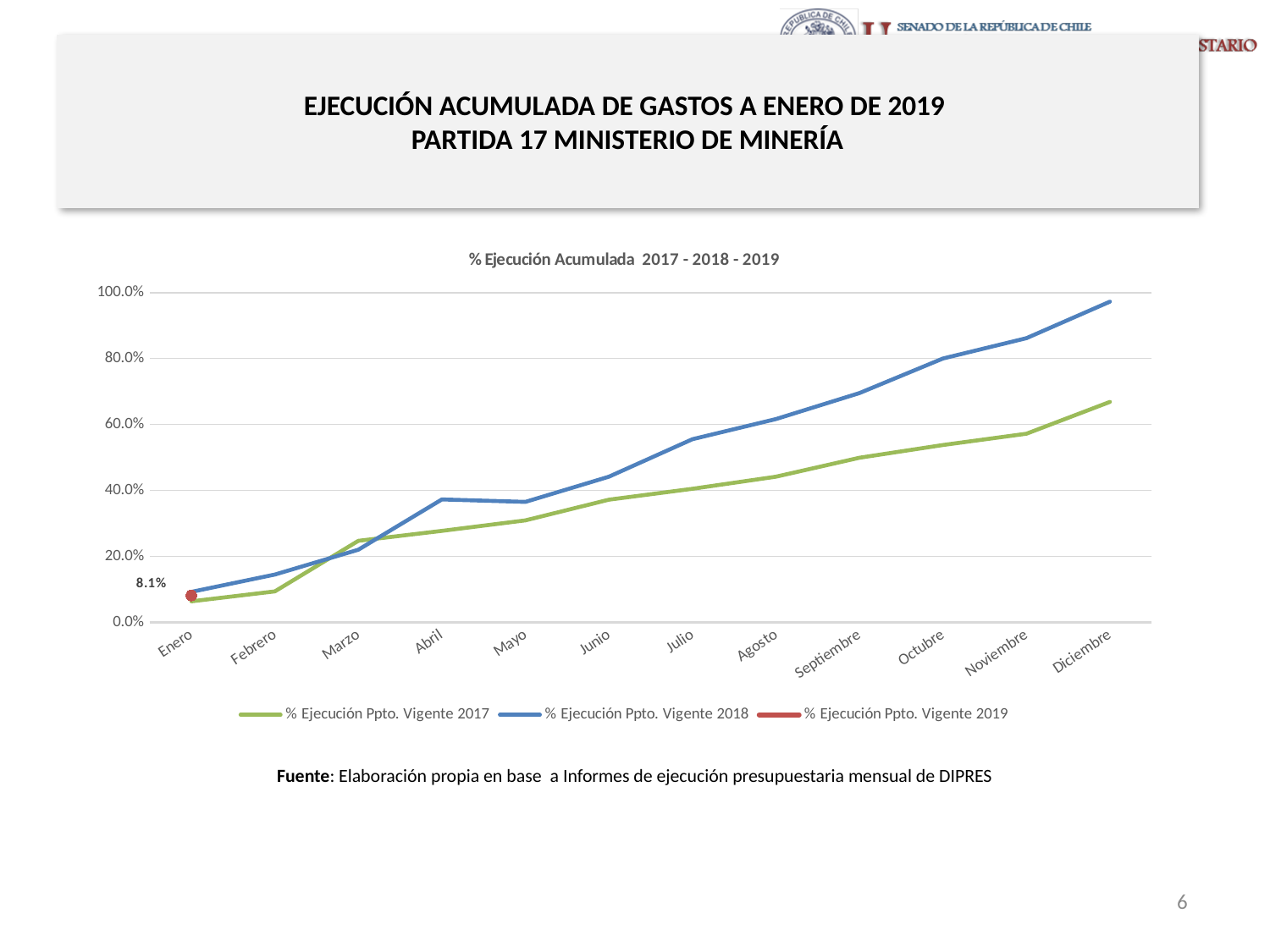
Does the % Ejecución Ppto. Vigente 2018 line rise or fall from Enero to Diciembre? rise Is the value for % Ejecución Ppto. Vigente 2018 in Diciembre greater or less than 80.0%? greater How many series does the legend list? 3 In which month does % Ejecución Ppto. Vigente 2018 reach its highest value? Diciembre What is the title of the chart? % Ejecución Acumulada 2017 - 2018 - 2019 In which month is % Ejecución Ppto. Vigente 2017 at its lowest value? Enero Is the value for % Ejecución Ppto. Vigente 2017 in Diciembre greater or less than 80.0%? less What kind of chart is shown on the slide? line chart What is the value for % Ejecución Ppto. Vigente 2019 in Enero? 8.1% In Diciembre, which series has the larger value, % Ejecución Ppto. Vigente 2017 or % Ejecución Ppto. Vigente 2018? % Ejecución Ppto. Vigente 2018 How many months are shown along the x axis? 12 In Abril, which series has the larger value, % Ejecución Ppto. Vigente 2017 or % Ejecución Ppto. Vigente 2018? % Ejecución Ppto. Vigente 2018